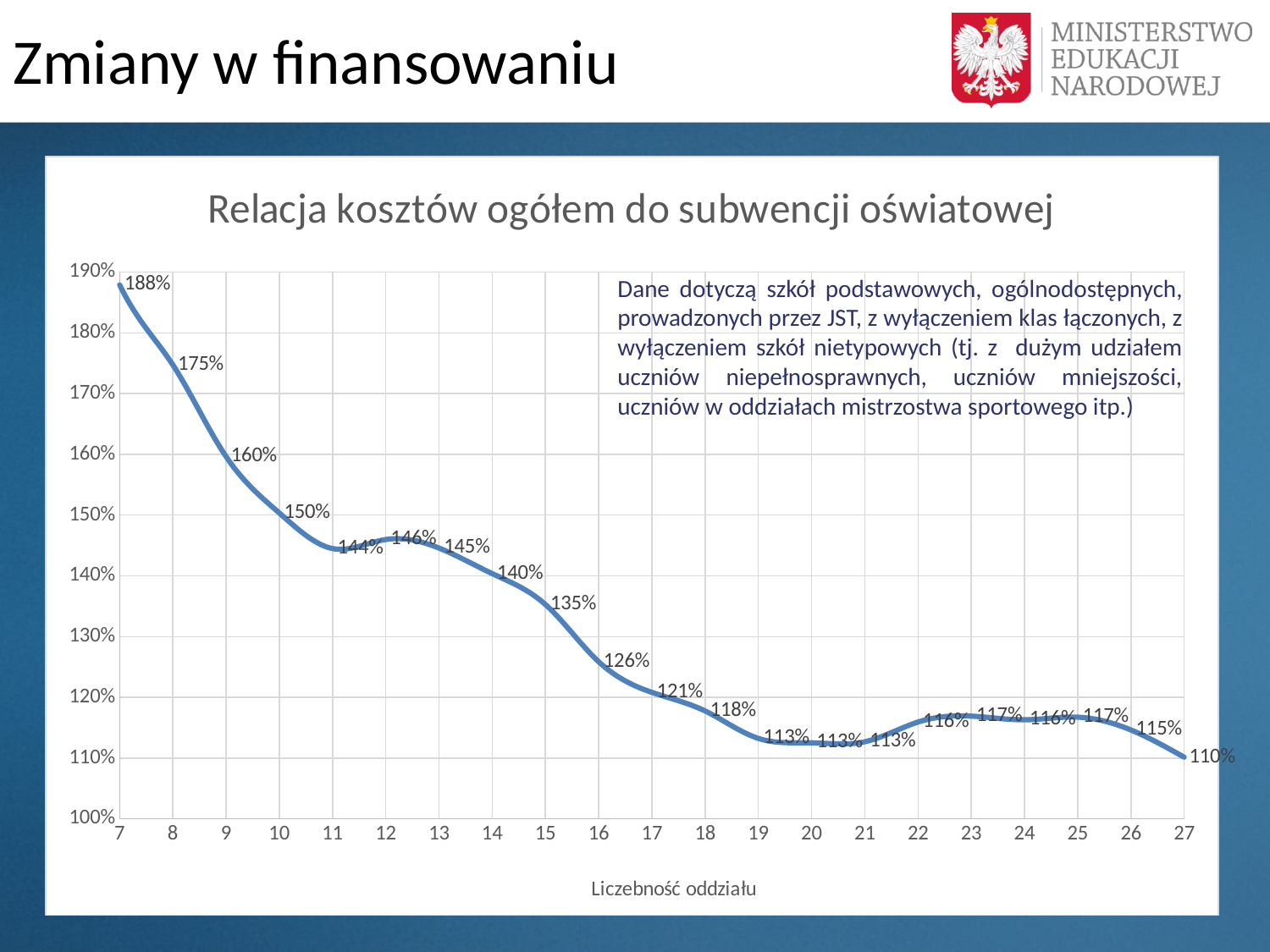
Which class size has the highest value on the chart? 7 What is the value for a class size of 15? 135% What is the x-axis label of the chart? Liczebność oddziału What type of chart is shown on the slide? line chart How many data points are plotted on the chart? 21 Do the values generally rise or fall as class size increases from 7 to 27? fall What is the difference between the value for class size 7 and the value for class size 8? 13% Which class size has the lowest value on the chart? 27 Which is larger, the value for class size 12 or the value for class size 14? class size 12 What is the value for a class size of 27? 110% What is the value for a class size (Liczebność oddziału) of 7? 188% What is the title of the chart? Relacja kosztów ogółem do subwencji oświatowej